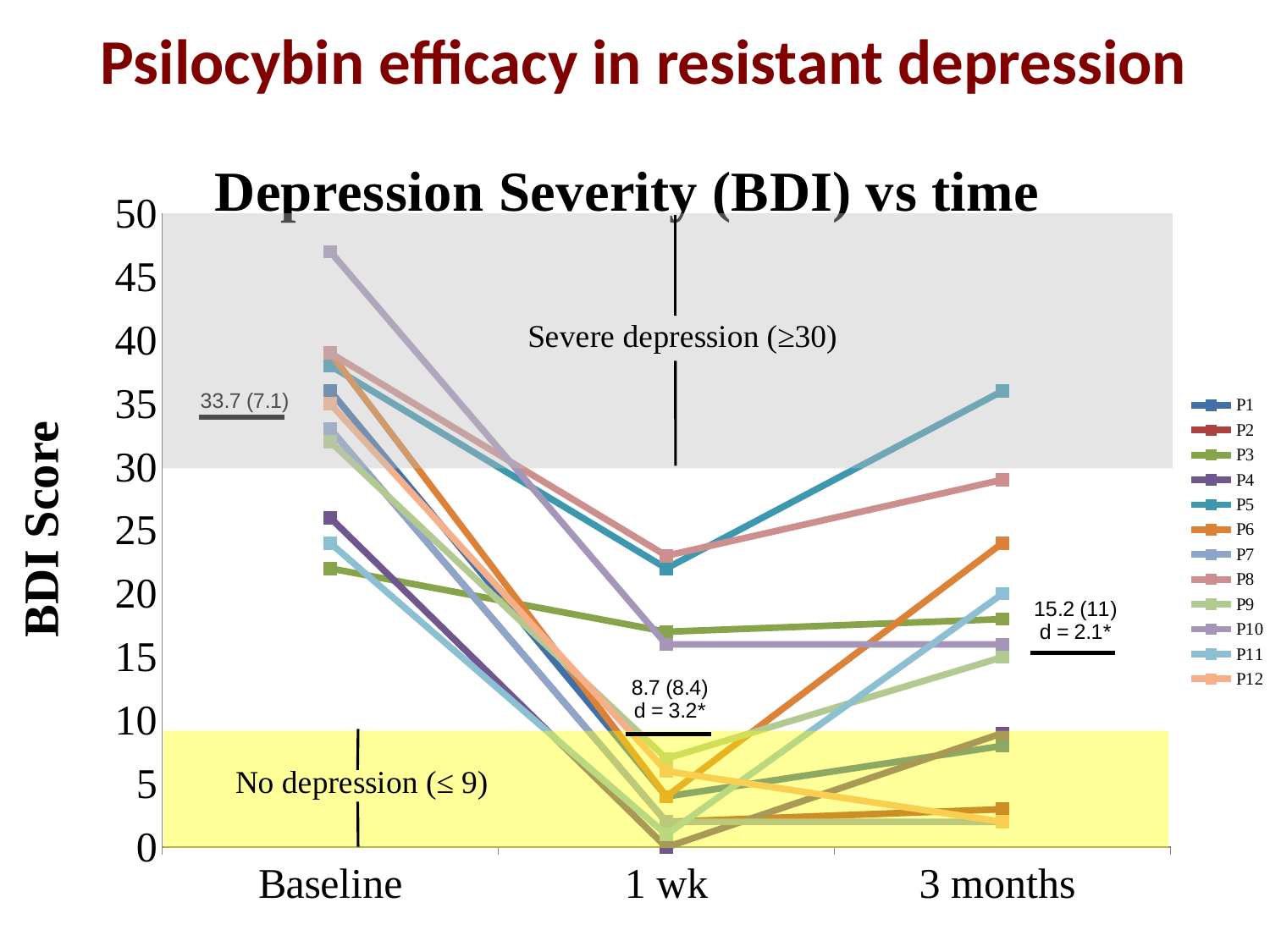
What mean (SD) value is annotated at 1 wk? 8.7 (8.4) Is the value for P10 at Baseline greater or less than 40? greater Is the value for P5 at 3 months greater or less than 30? greater What effect size (d) is annotated at 1 wk? d = 3.2* What is the title of the chart? Depression Severity (BDI) vs time What is the label on the y axis? BDI Score How many time points are shown on the x axis? 3 What kind of chart is shown on the slide? line chart What mean (SD) value is annotated at Baseline? 33.7 (7.1) How many series does the legend list? 12 What effect size (d) is annotated at 3 months? d = 2.1* From Baseline to 1 wk, do the BDI scores generally rise or fall? fall